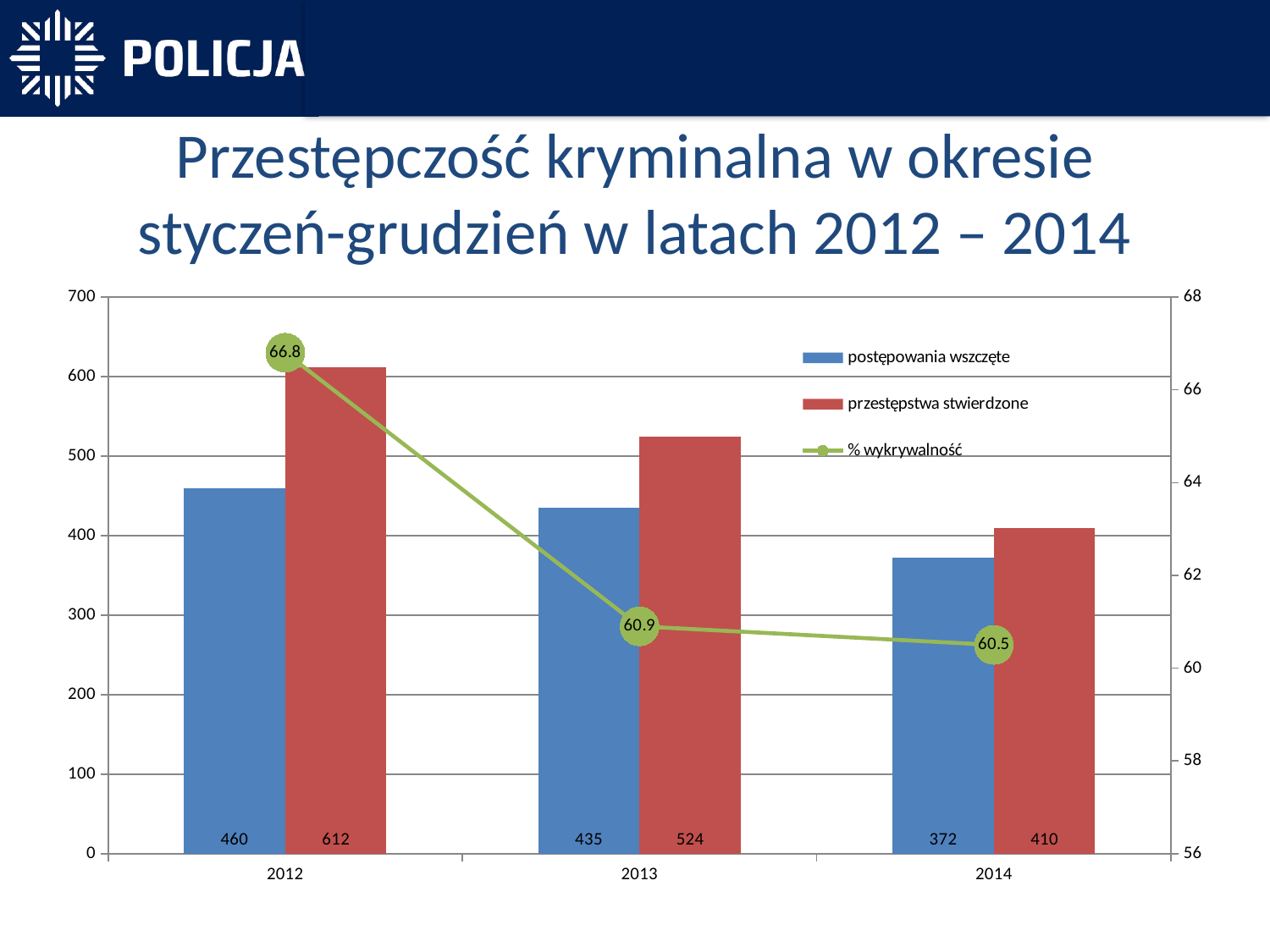
What is the difference between przestępstwa stwierdzone and postępowania wszczęte in 2013? 89 What is the value of przestępstwa stwierdzone for 2014? 410 What kind of chart is this? Combined bar and line chart Is the value of przestępstwa stwierdzone for 2012 greater or less than 600? greater Does the % wykrywalność line rise or fall from 2012 to 2014? fall What is the value of postępowania wszczęte for 2012? 460 Which year has the lowest value of postępowania wszczęte? 2014 What is the % wykrywalność value for 2013? 60.9 How many years are shown on the x axis? 3 Which year has the highest value of przestępstwa stwierdzone? 2012 Which is larger in 2014: postępowania wszczęte or przestępstwa stwierdzone? przestępstwa stwierdzone How many series does the legend list? 3